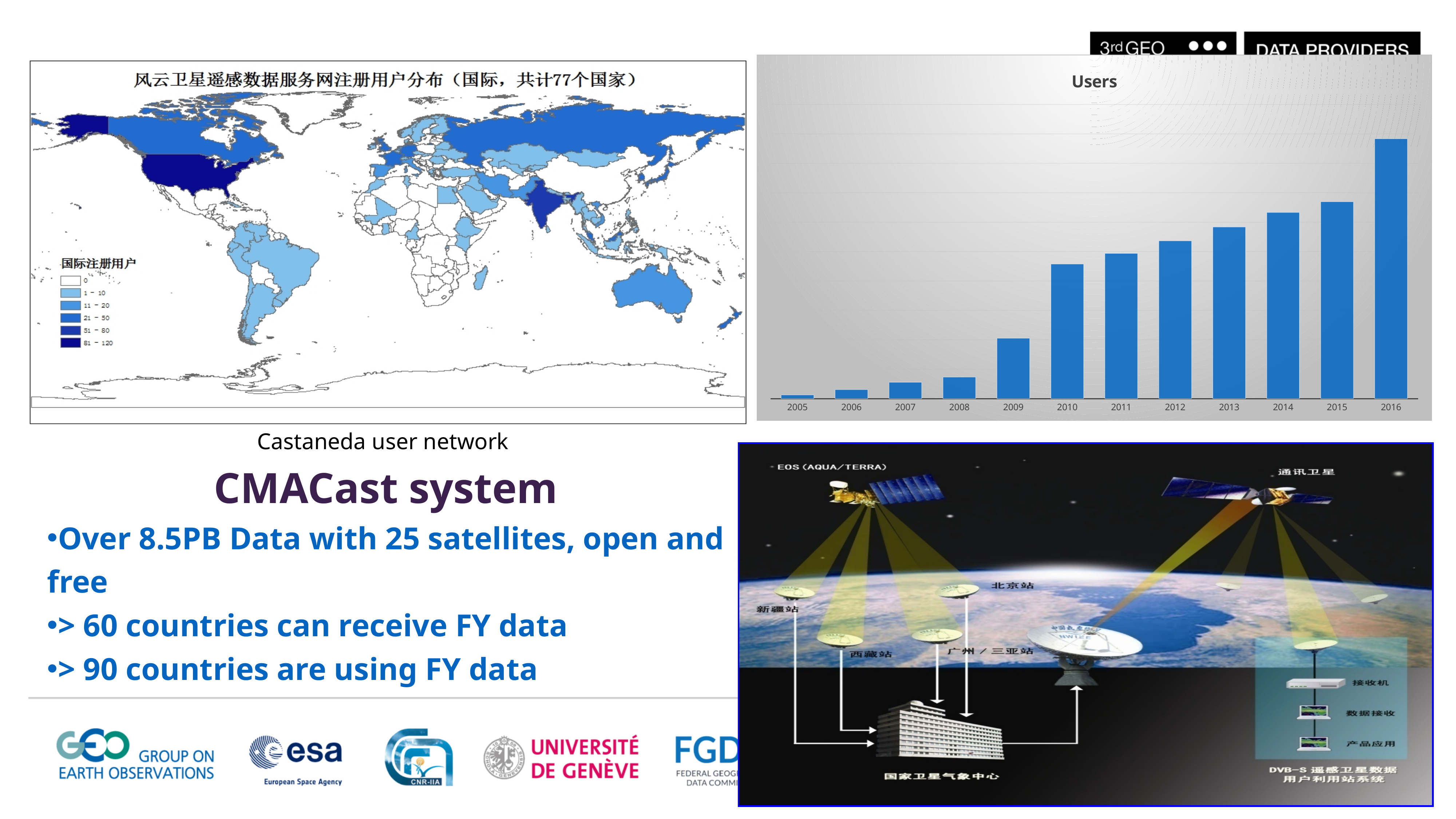
In the "Users" chart, what is the first year shown on the x axis? 2005 In the "Users" chart, how many years are shown on the x axis? 12 What is the title of the bar chart on the right side of the slide? Users In the "Users" chart, do the values rise or fall from 2005 to 2016? rise In the "Users" chart, which year has the larger value, 2008 or 2012? 2012 In the "Users" chart, which year has the lowest value? 2005 In the "Users" chart, which year has the larger value, 2009 or 2010? 2010 In the "Users" chart, which year has the larger value, 2006 or 2007? 2007 In the "Users" chart, which year has the highest value? 2016 What kind of chart is the "Users" chart? bar chart